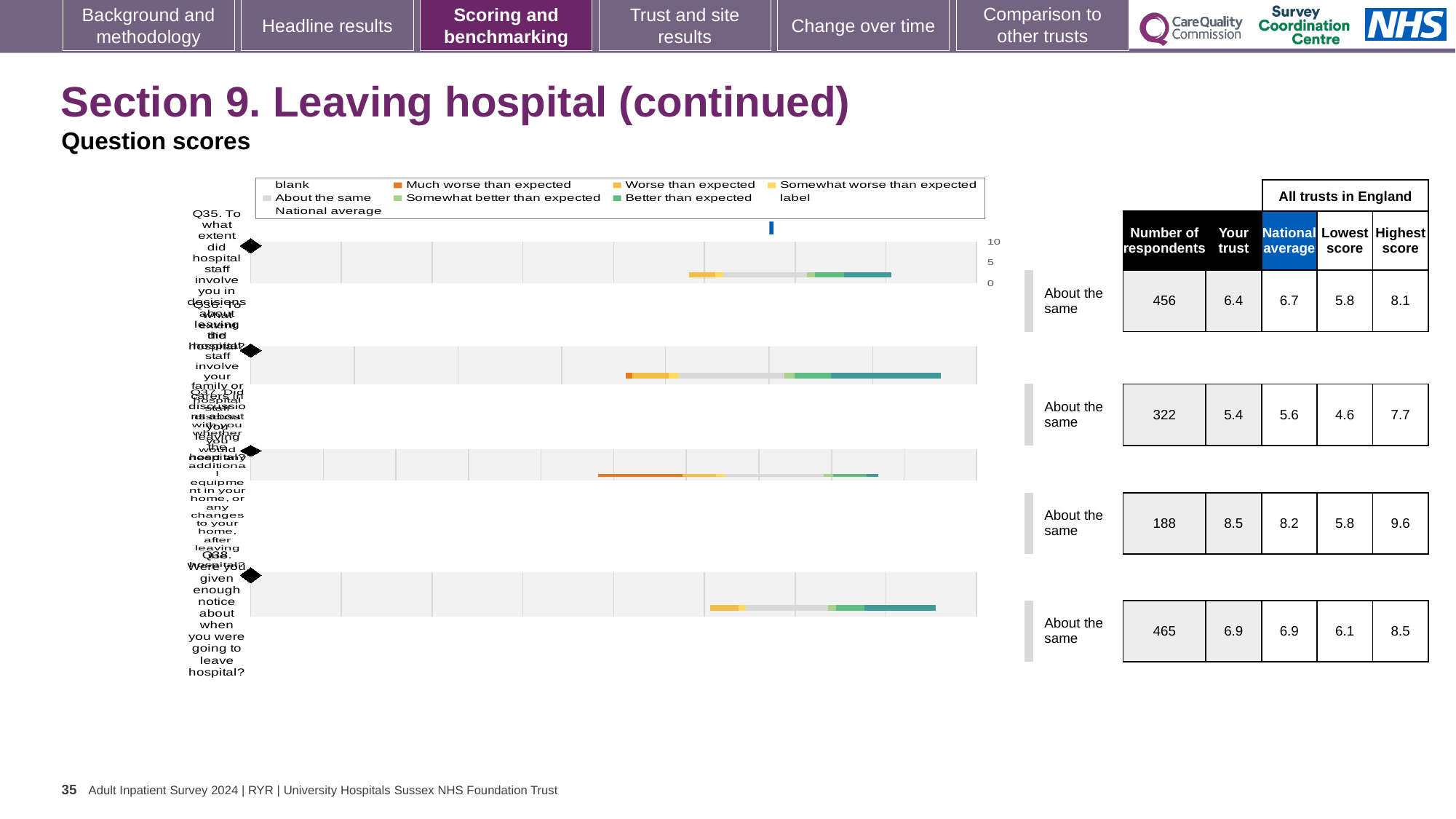
How many respondents are listed for Q35 (the first row)? 456 What benchmark label is shown beside each of the four bars? About the same How many questions (bars) are plotted in the chart? 4 What is the national average for Q38 (the last row)? 6.9 Which row has the lowest number of respondents? the third row (188) For Q35, what is the difference between the national average and the 'Your trust' score? 0.3 How many entries does the chart legend list? 9 What is the 'Your trust' score for Q35 (the first row)? 6.4 What kind of chart is used to show the question scores on this slide? bar chart Which row has the highest 'Your trust' score? the third row (8.5) What is the highest score among all trusts in England for the third row? 9.6 For Q35, which is larger: the 'Your trust' score or the national average? national average